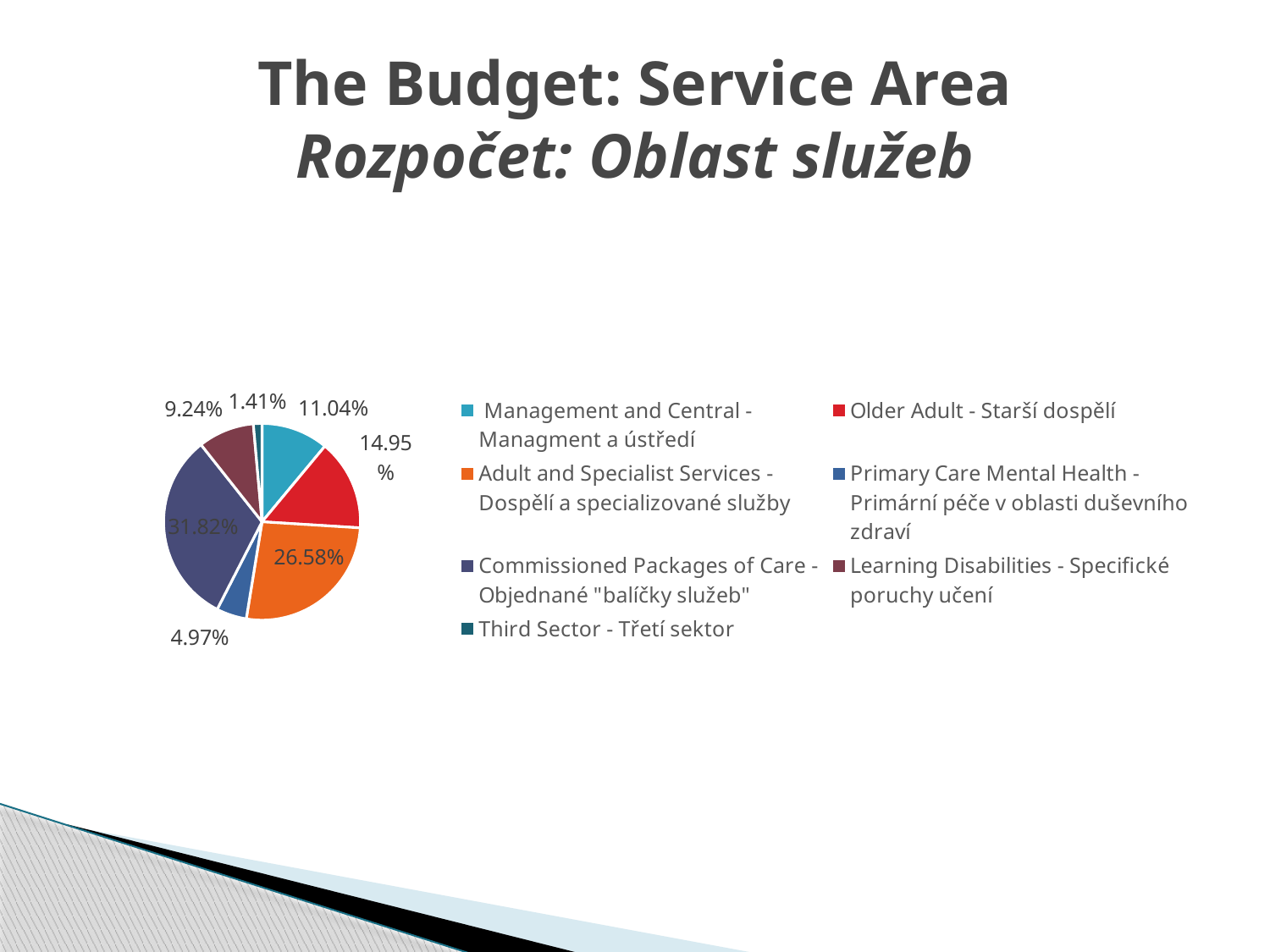
Which service area has the smallest share of the budget? Third Sector How many slices does the pie chart have? 7 What is the difference in percentage points between Commissioned Packages of Care and Adult and Specialist Services? 5.24 What share of the budget goes to Commissioned Packages of Care? 31.82% What percentage is shown for Management and Central? 11.04% What percentage is shown for Third Sector? 1.41% What type of chart is shown on the slide? pie chart What percentage is shown for Older Adult? 14.95% What share of the budget goes to Adult and Specialist Services? 26.58% Which is larger, the share for Learning Disabilities or the share for Primary Care Mental Health? Learning Disabilities What is the title of the slide containing the pie chart? The Budget: Service Area Which service area has the largest share of the budget? Commissioned Packages of Care